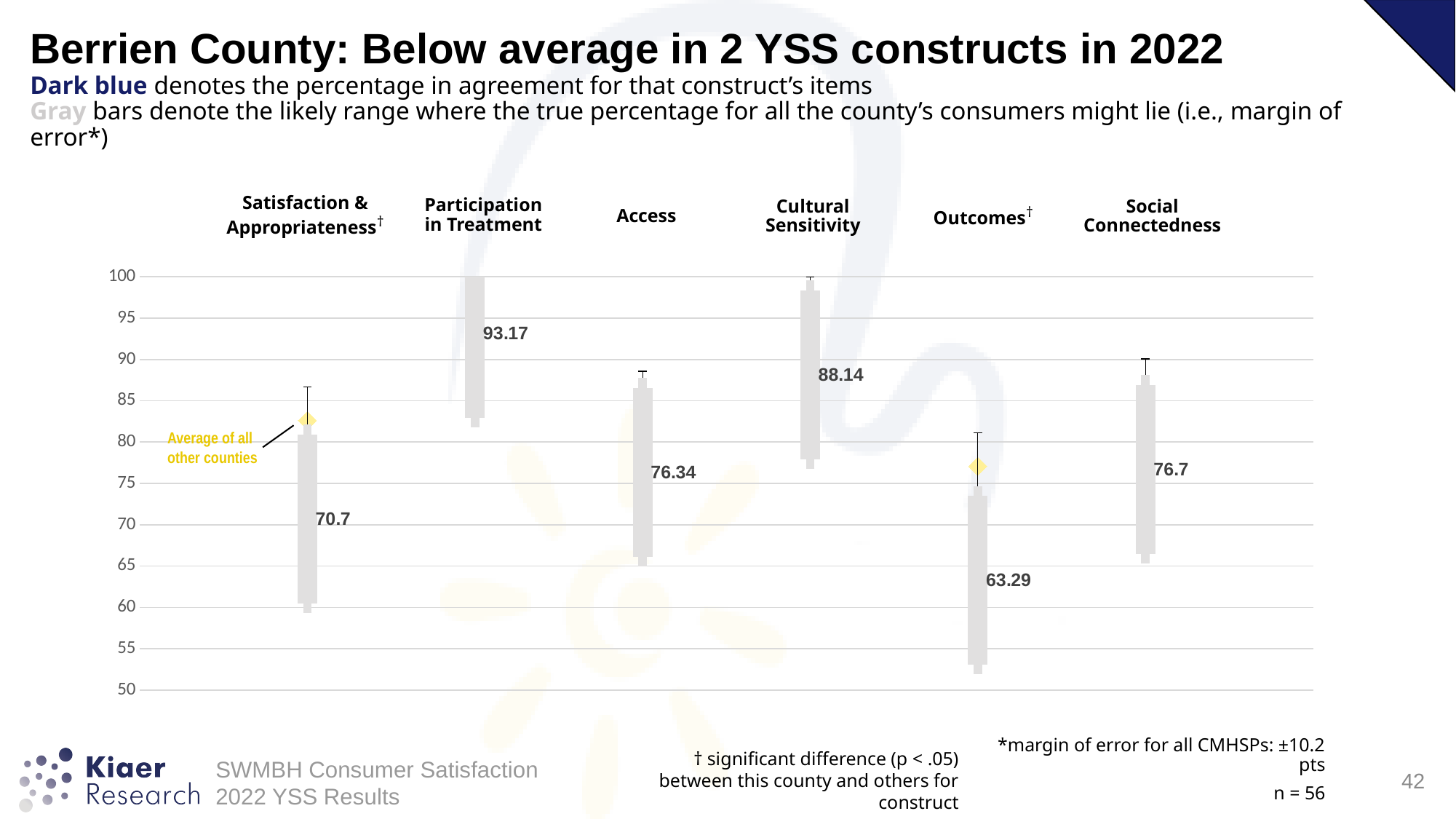
Which construct has the highest percentage in agreement? Participation in Treatment How many constructs are shown on the chart? 6 What is the difference between the percentage in agreement for Cultural Sensitivity and for Satisfaction & Appropriateness? 17.44 What is the percentage in agreement for Cultural Sensitivity? 88.14 What is the percentage in agreement for Outcomes? 63.29 What kind of chart is shown on the slide? Bar chart What is the percentage in agreement for Participation in Treatment? 93.17 What is the difference between the percentage in agreement for Participation in Treatment and for Outcomes? 29.88 Which construct has the lowest percentage in agreement? Outcomes What does the yellow diamond on the chart represent? Average of all other counties What is the percentage in agreement for Satisfaction & Appropriateness? 70.7 Which has a higher percentage in agreement, Access or Social Connectedness? Social Connectedness